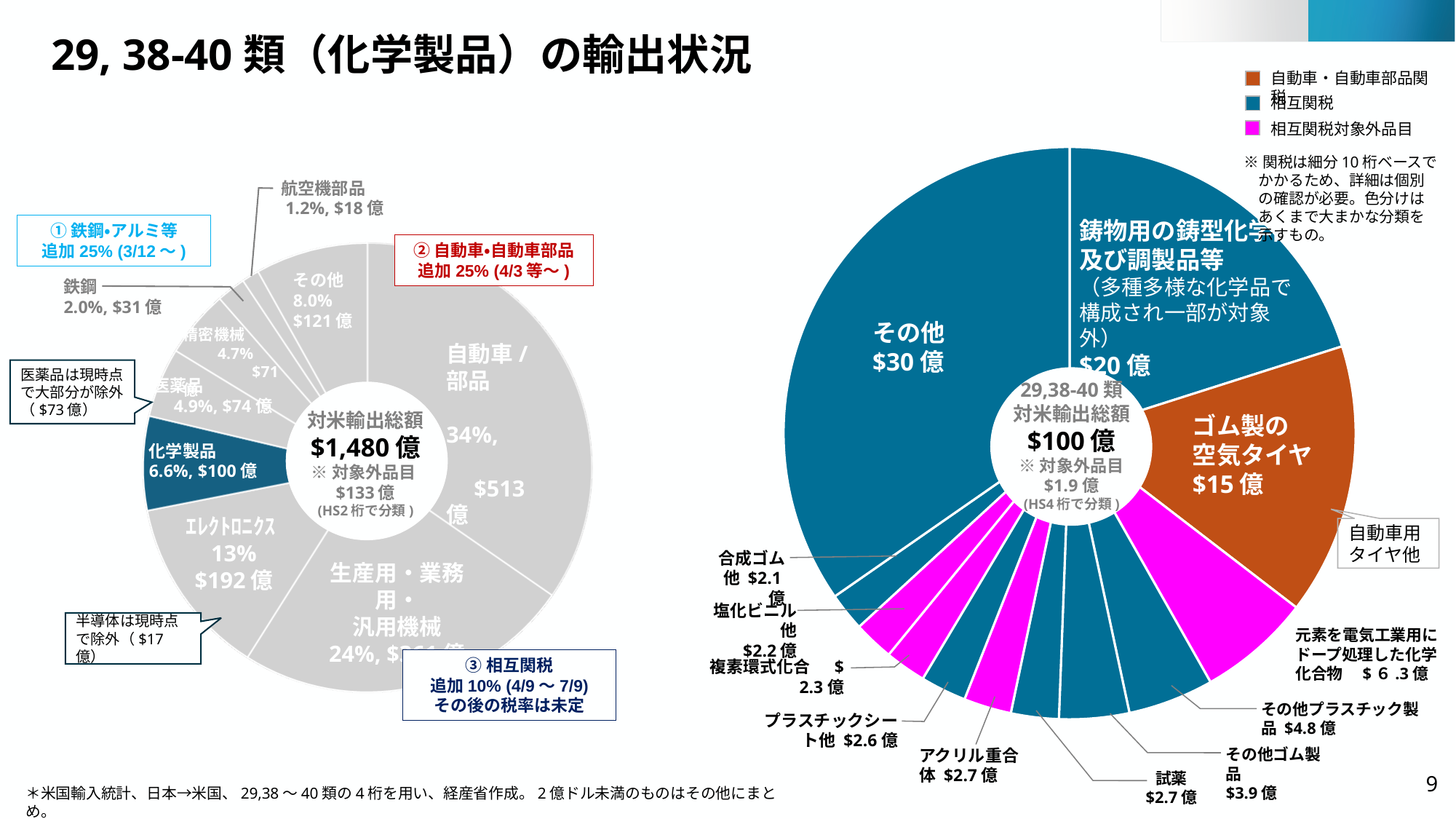
On the right donut chart, which is larger: その他ゴム製品 or 複素環式化合物? その他ゴム製品 On the left donut chart, which category has the largest share? 自動車 / 部品 What type of chart is used on the right side of the slide? Pie (donut) chart On the left donut chart, what is the value shown for 化学製品? 6.6%, $100 億 How many entries does the legend at the top right of the slide list? 3 On the right donut chart, what is the value for その他プラスチック製品? $4.8 億 On the right donut chart, which slice is the largest? その他 On the left donut chart, which labelled category has the smallest share? 航空機部品 On the left donut chart, what total is shown in the centre (対米輸出総額)? $1,480 億 On the right donut chart, what is the difference between 鋳物用の鋳型化学品及び調製品等 and ゴム製の空気タイヤ? $5 億 On the left donut chart, what is the value shown for エレクトロニクス? 13%, $192 億 On the right donut chart, what is the value for ゴム製の空気タイヤ? $15 億